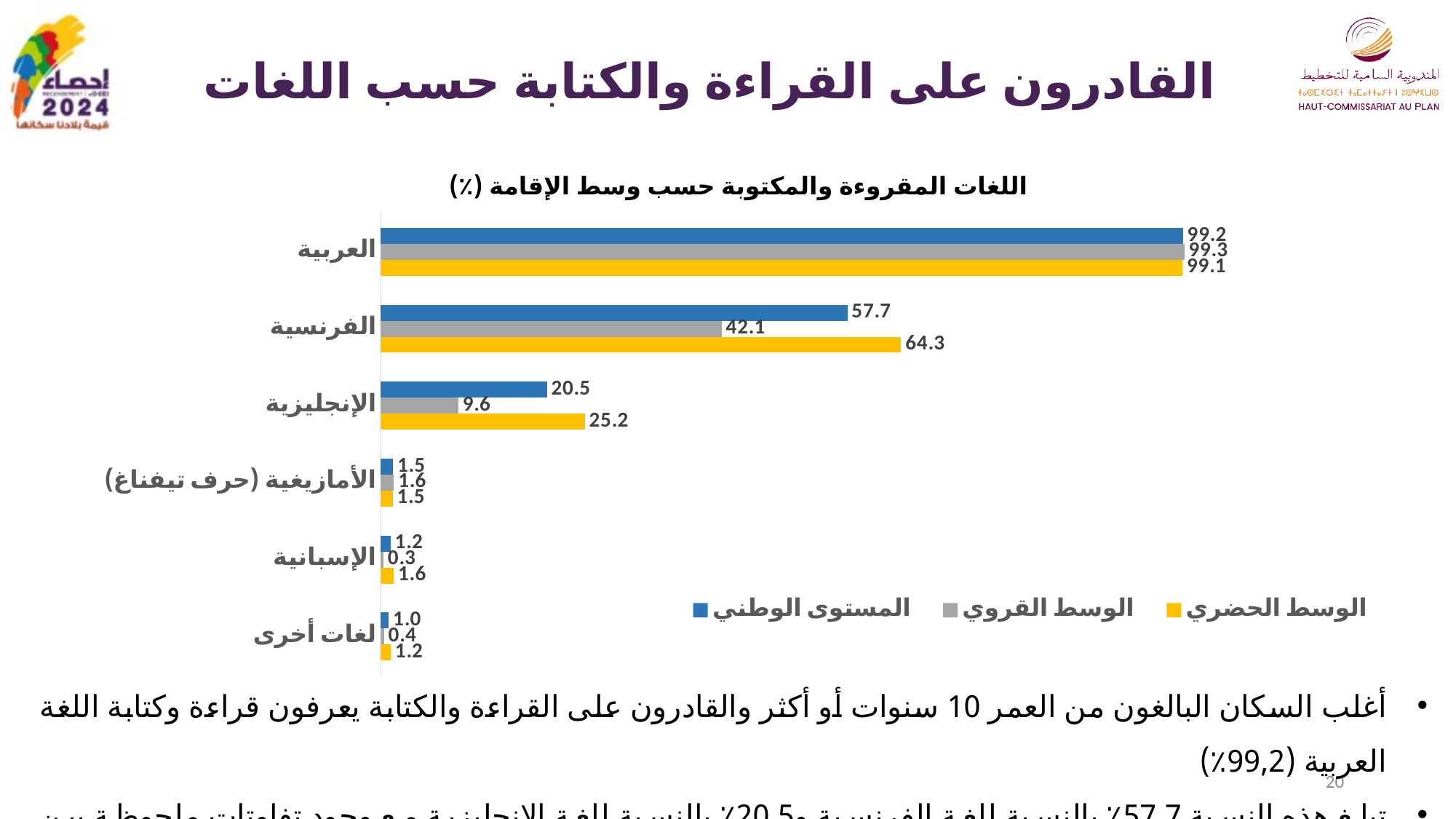
What is the value for الفرنسية in the الوسط الحضري series? 64.3 Which language has the lowest value in the الوسط القروي series? الإسبانية What is the value for الإسبانية in the الوسط القروي series? 0.3 What is the value for الإنجليزية in the الوسط القروي series? 9.6 What type of chart is shown on the slide? bar chart What is the difference between the الوسط الحضري and الوسط القروي values for الفرنسية? 22.2 For الإنجليزية, which is larger: the الوسط الحضري value or the المستوى الوطني value? الوسط الحضري How many series does the chart legend list? 3 How many language categories are shown in the chart? 6 What is the value for الفرنسية in the المستوى الوطني series? 57.7 Which colour represents the الوسط الحضري series in the chart? yellow Which language has the highest value in the المستوى الوطني series? العربية